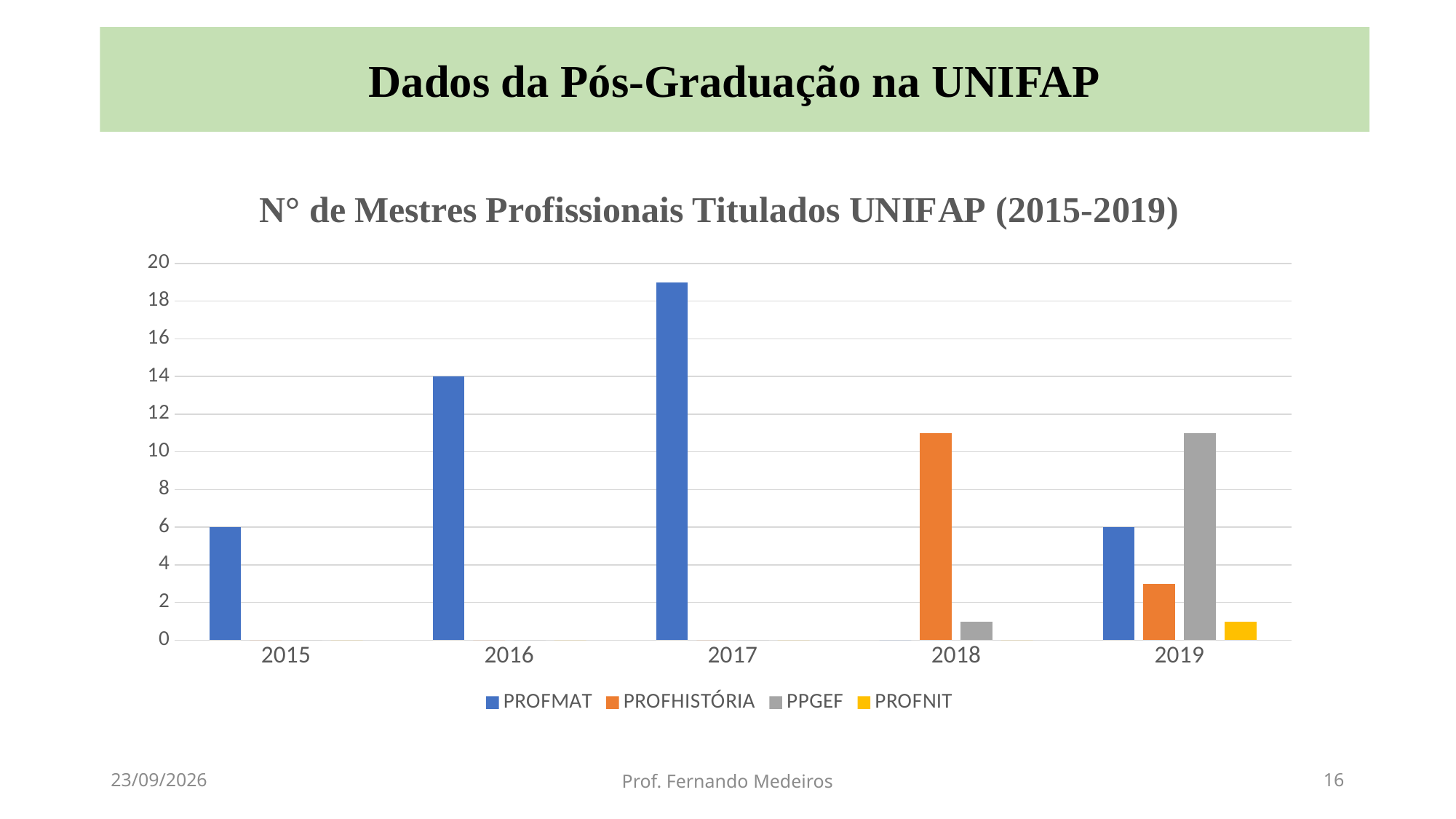
How many series does the legend list? 4 Is the value for PROFHISTÓRIA in 2018 greater or less than 10? greater What is the difference between the PROFMAT values for 2016 and 2015? 8 Is the value for PROFMAT in 2017 greater or less than 18? greater What type of chart is shown on the slide? bar chart In which year is the PROFMAT bar highest? 2017 What is the value for PROFMAT in 2019? 6 What is the value for PROFMAT in 2016? 14 How many years are shown on the x axis? 5 Which series is shown in orange in the legend? PROFHISTÓRIA Is the value for PROFHISTÓRIA in 2019 greater or less than 4? less What is the value for PROFMAT in 2015? 6